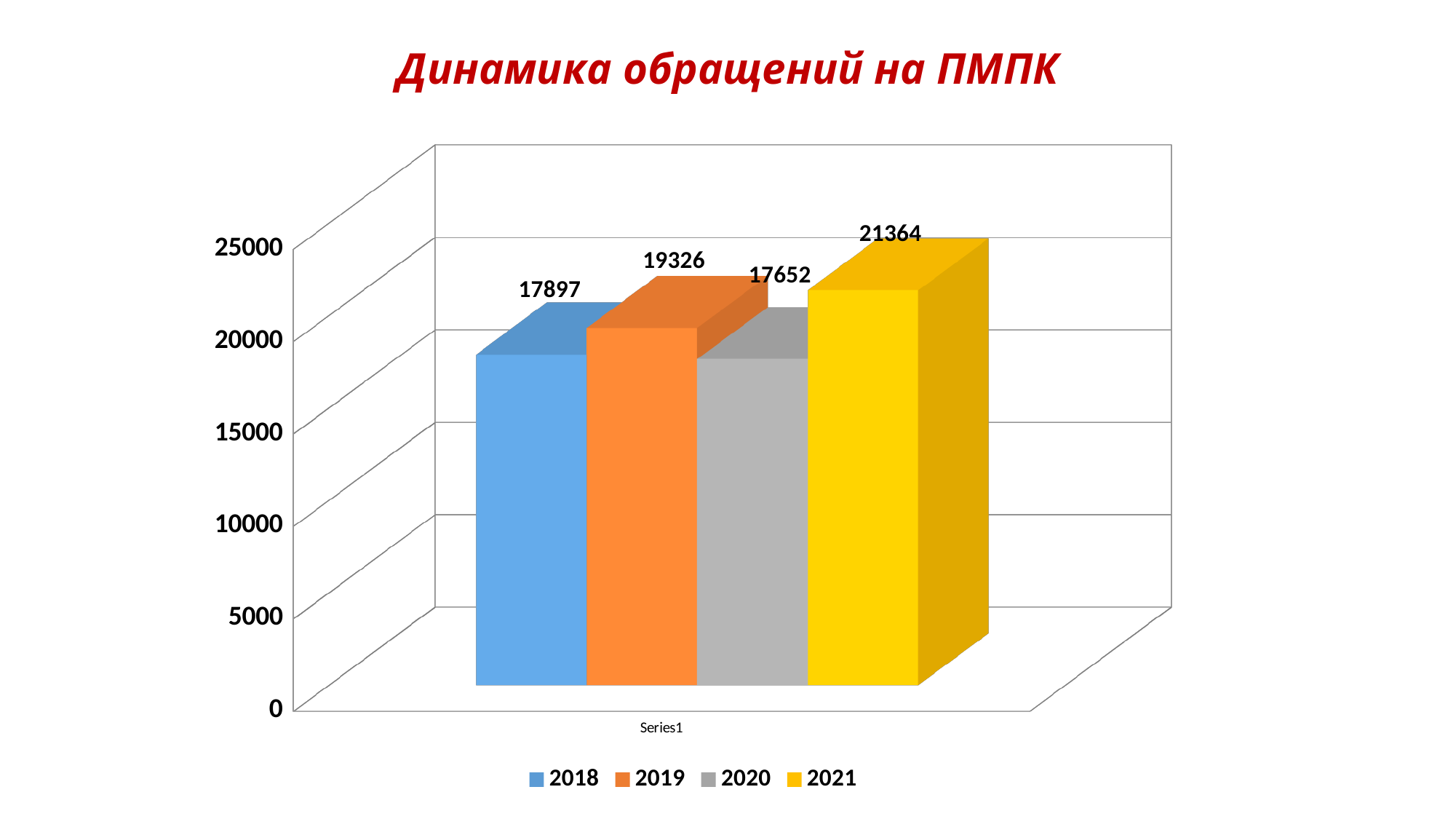
What is the value for 2018? 17897 What kind of chart is shown on the slide? Bar chart What is the difference between the values for 2021 and 2018? 3467 Which year has the lowest value? 2020 How many series does the legend list? 4 Which year has the highest value? 2021 What is the title of the chart? Динамика обращений на ПМПК What is the value for 2020? 17652 What is the value for 2019? 19326 What is the difference between the values for 2019 and 2020? 1674 What is the value for 2021? 21364 Which is larger, the value for 2019 or the value for 2021? 2021